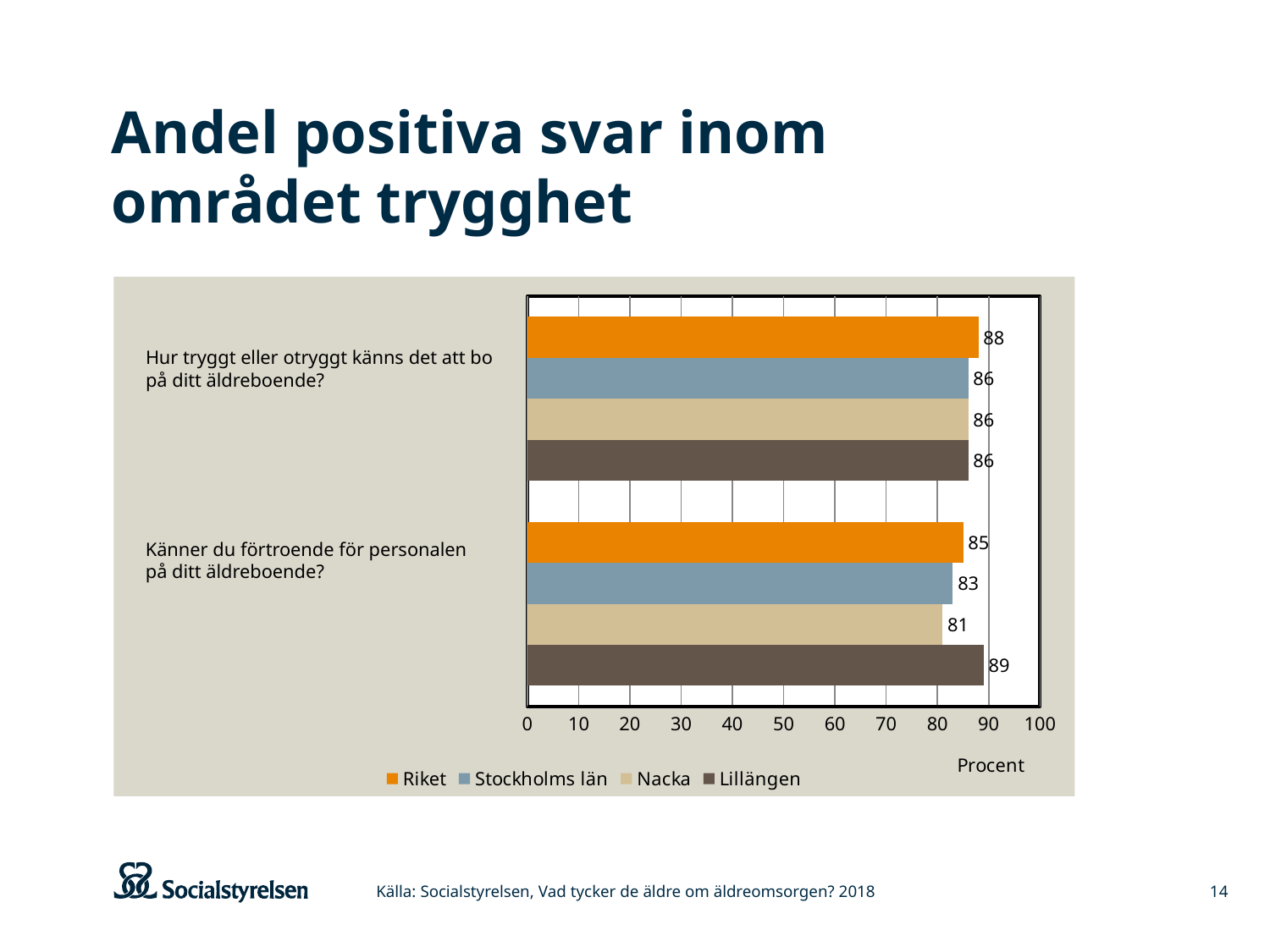
What is the difference between the Lillängen and Nacka values on the question "Känner du förtroende för personalen på ditt äldreboende?"? 8 What is the value for Stockholms län on the question "Känner du förtroende för personalen på ditt äldreboende?"? 83 What is the value for Riket on the question "Hur tryggt eller otryggt känns det att bo på ditt äldreboende?"? 88 Is the value for Nacka on "Känner du förtroende för personalen på ditt äldreboende?" greater or less than 90? less What is the label of the horizontal axis? Procent What is the value for Nacka on the question "Känner du förtroende för personalen på ditt äldreboende?"? 81 Which series has the highest value on the question "Känner du förtroende för personalen på ditt äldreboende?"? Lillängen What kind of chart is shown on the slide? Bar chart What is the value for Lillängen on the question "Känner du förtroende för personalen på ditt äldreboende?"? 89 How many series does the legend list? 4 Which series has the lowest value on the question "Känner du förtroende för personalen på ditt äldreboende?"? Nacka Which is larger: the Riket value for "Hur tryggt eller otryggt känns det att bo på ditt äldreboende?" or the Riket value for "Känner du förtroende för personalen på ditt äldreboende?"? Hur tryggt eller otryggt känns det att bo på ditt äldreboende?